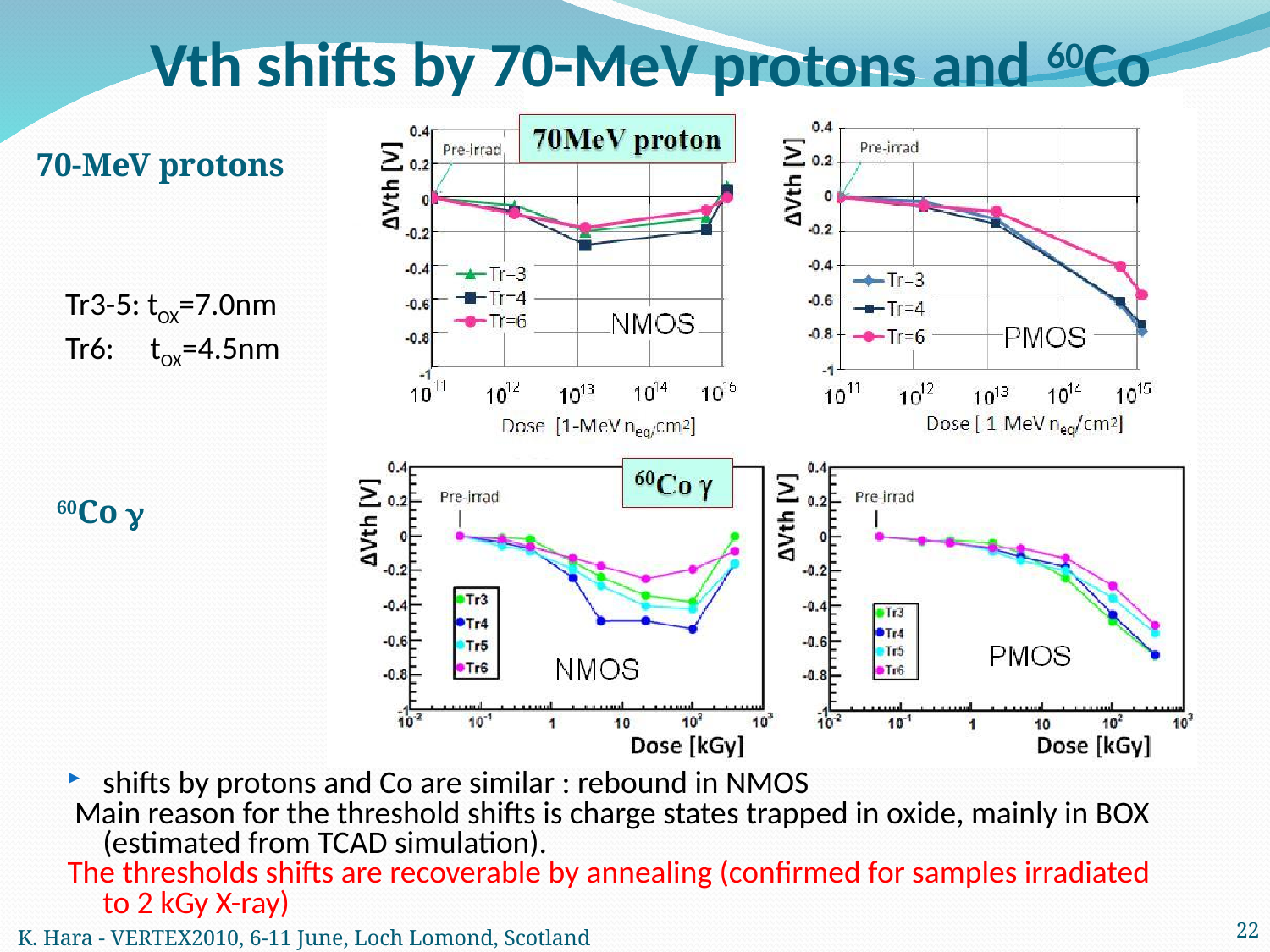
In the bottom-right 60Co γ PMOS chart, is the value for Tr6 at a dose of 10^2 kGy greater or less than -0.4? greater What kind of chart is the top-left chart labelled 70MeV proton NMOS? line chart In the bottom-left 60Co γ NMOS chart, is the value for Tr4 at a dose of 10^2 kGy greater or less than -0.4? less In the top-right 70MeV proton PMOS chart, which series has the higher ΔVth at a dose of 10^15, Tr=4 or Tr=6? Tr=6 In the top-left 70MeV proton NMOS chart, is the value for Tr=4 at a dose of 10^13 greater or less than -0.2? less In the bottom-left 60Co γ NMOS chart, which series has the lower ΔVth at a dose of 10 kGy, Tr4 or Tr6? Tr4 What are the legend entries of the bottom-right 60Co γ PMOS chart? Tr3, Tr4, Tr5, Tr6 What is the x-axis label of the bottom-left 60Co γ NMOS chart? Dose [kGy] How many series does the legend of the bottom-left 60Co γ NMOS chart list? 4 In the top-right 70MeV proton PMOS chart, do the ΔVth values rise or fall as the dose increases? fall How many series does the legend of the top-left 70MeV proton NMOS chart list? 3